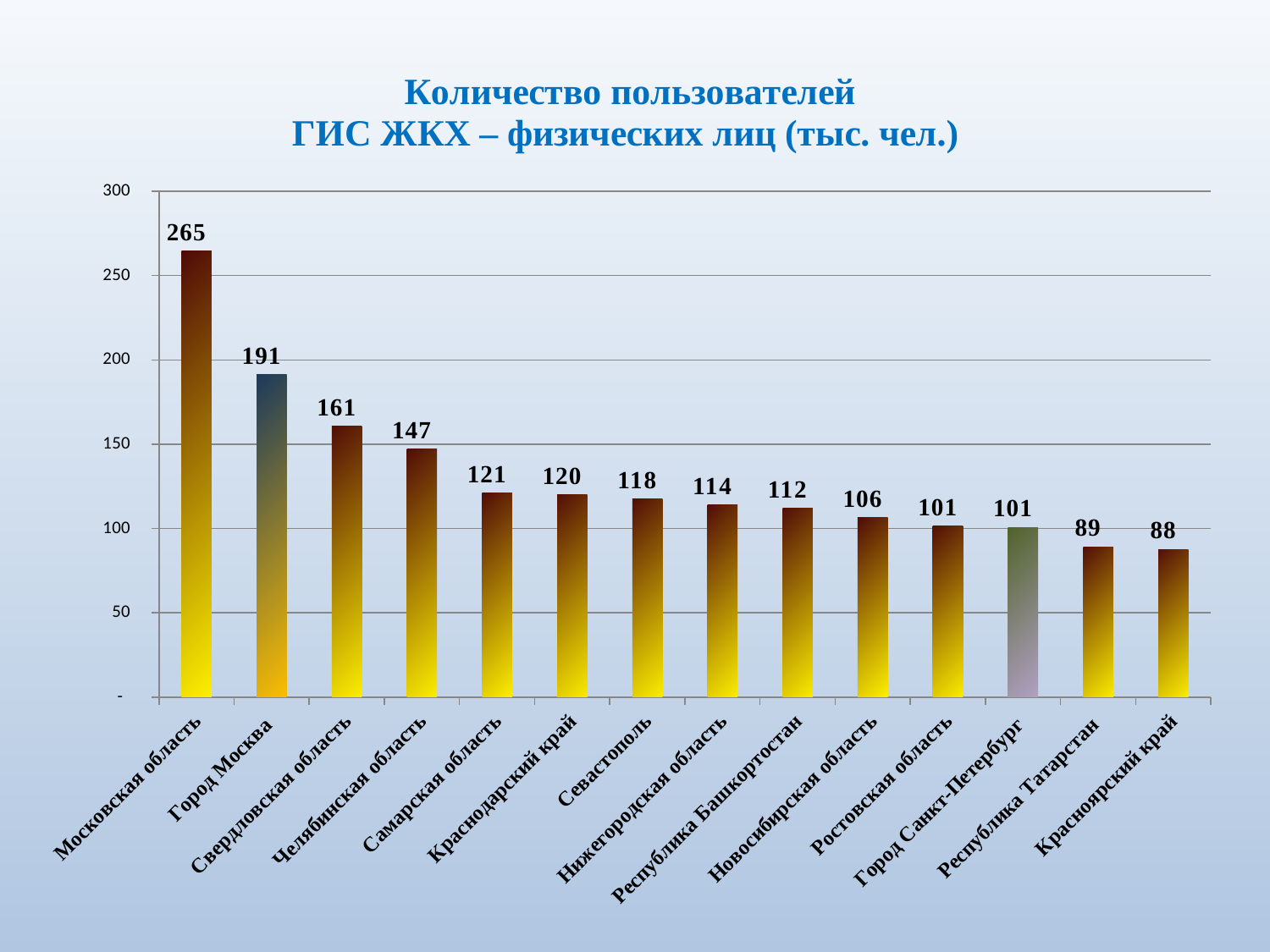
Which is larger, the value for Свердловская область or the value for Челябинская область? Свердловская область Which category has the lowest value? Красноярский край What is the value for Красноярский край? 88 Which category has the highest value? Московская область Do the values rise or fall from left to right along the x axis? fall How many categories are shown on the chart? 14 What is the value for Московская область? 265 What is the value for Город Москва? 191 Is the value for Севастополь greater or less than 100? greater What is the difference between the values for Московская область and Город Москва? 74 What is the value for Республика Башкортостан? 112 What kind of chart is shown on the slide? bar chart